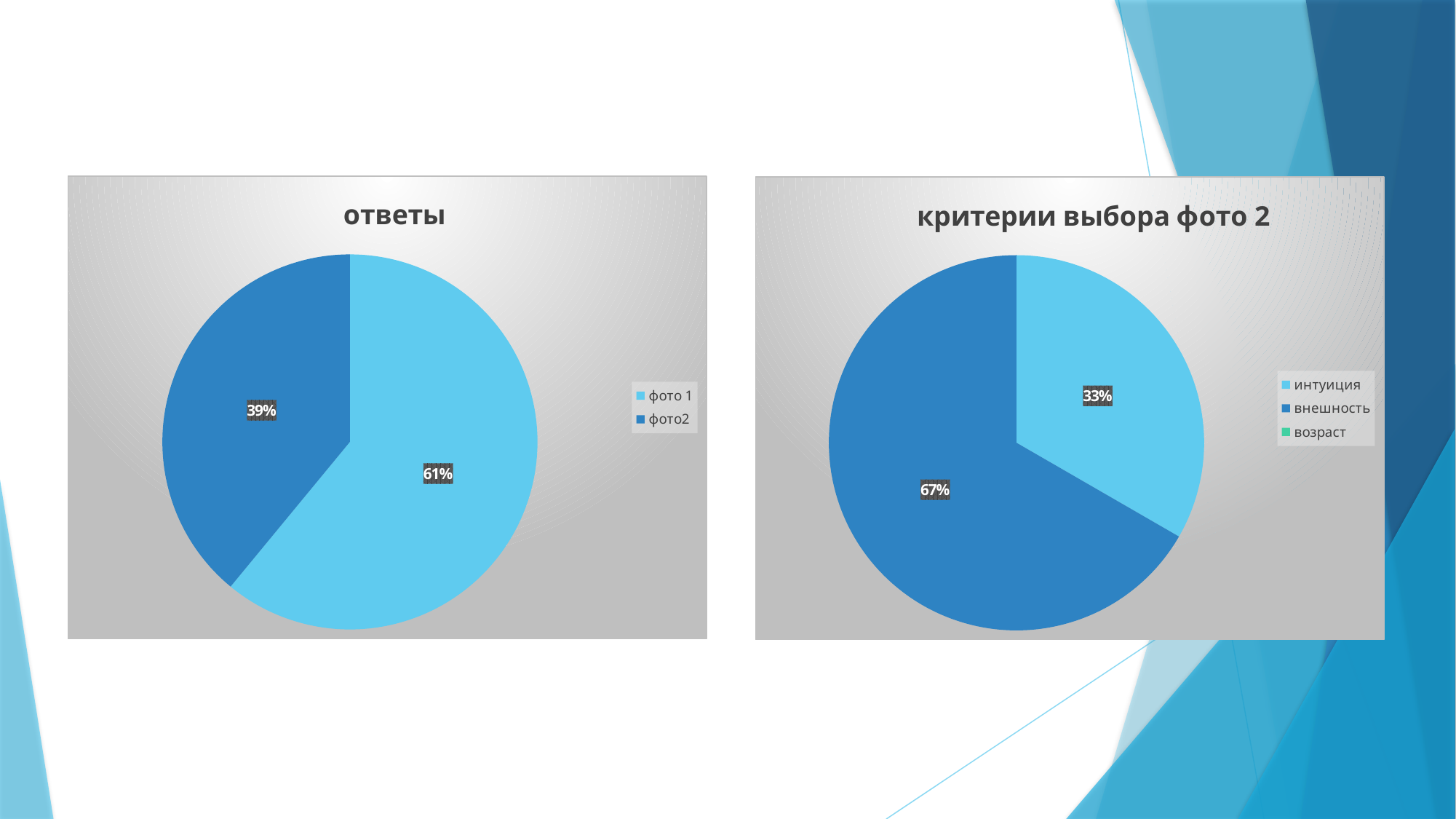
In the chart titled "критерии выбора фото 2", what is the difference between the shares of "внешность" and "интуиция"? 34% In the chart titled "ответы", what is the difference between the shares of "фото 1" and "фото2"? 22% In the chart titled "ответы", what share does "фото2" have? 39% In the chart titled "ответы", which category has the largest slice? фото 1 What kind of chart is the chart titled "ответы"? pie chart How many entries does the legend of the chart titled "ответы" list? 2 In the chart titled "ответы", what share does "фото 1" have? 61% In the chart titled "критерии выбора фото 2", which category has the largest slice? внешность In the chart titled "критерии выбора фото 2", which is larger: "интуиция" or "внешность"? внешность In the chart titled "критерии выбора фото 2", what share does "интуиция" have? 33% How many entries does the legend of the chart titled "критерии выбора фото 2" list? 3 In the chart titled "критерии выбора фото 2", what share does "внешность" have? 67%